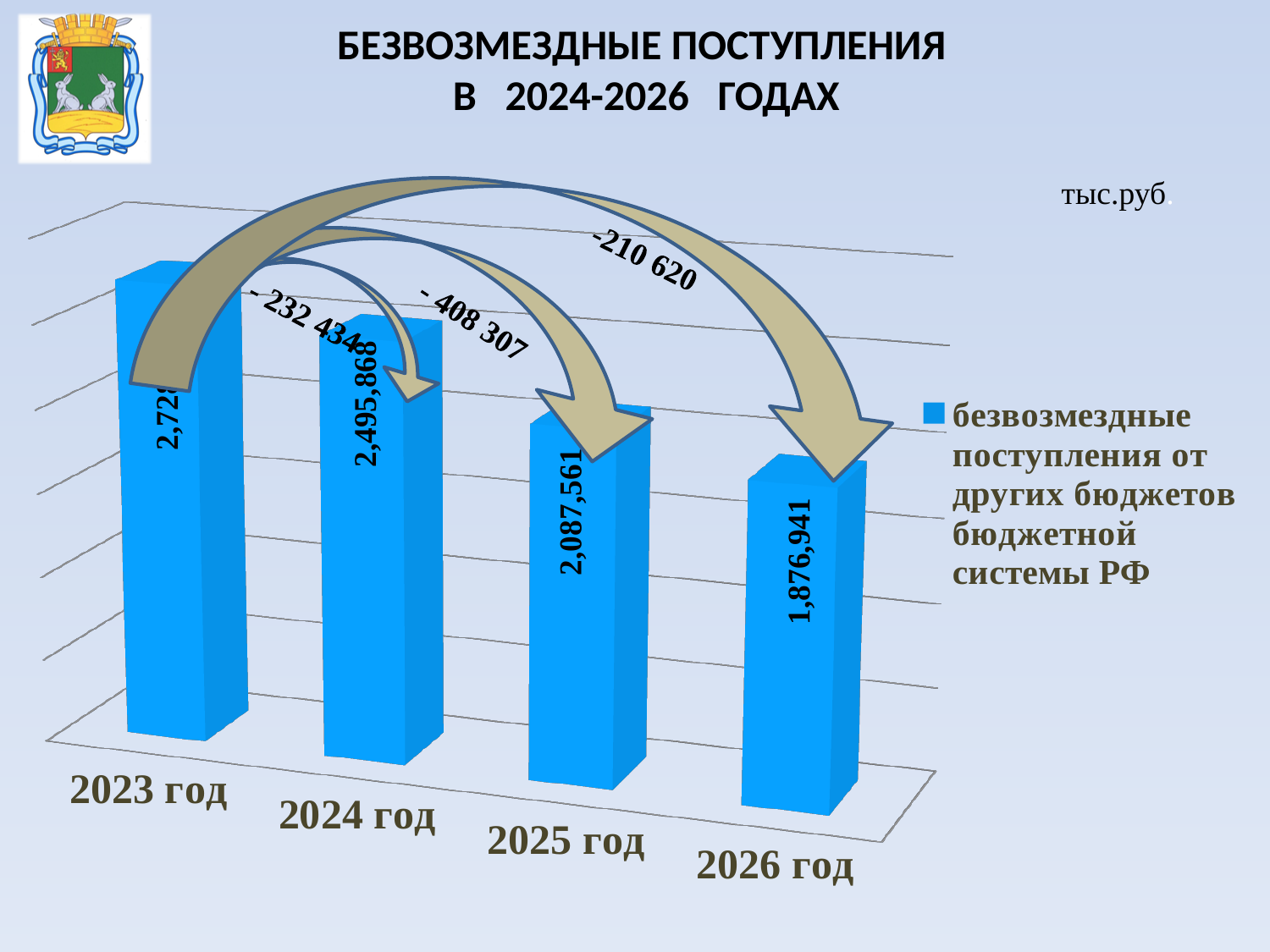
Which is larger, the value for 2024 год or for 2026 год? 2024 год Do the values rise or fall from 2023 год to 2026 год? fall Which year has the lowest value? 2026 год By how much does the value fall from 2024 год to 2025 год? 408 307 Which year has the highest bar? 2023 год How many years (bars) are shown on the chart? 4 By how much does the value fall from 2025 год to 2026 год? 210 620 How many series does the legend list? 1 What is the value for 2024 год? 2,495,868 What kind of chart is shown on the slide? bar chart What is the value for 2025 год? 2,087,561 What is the value for 2026 год? 1,876,941